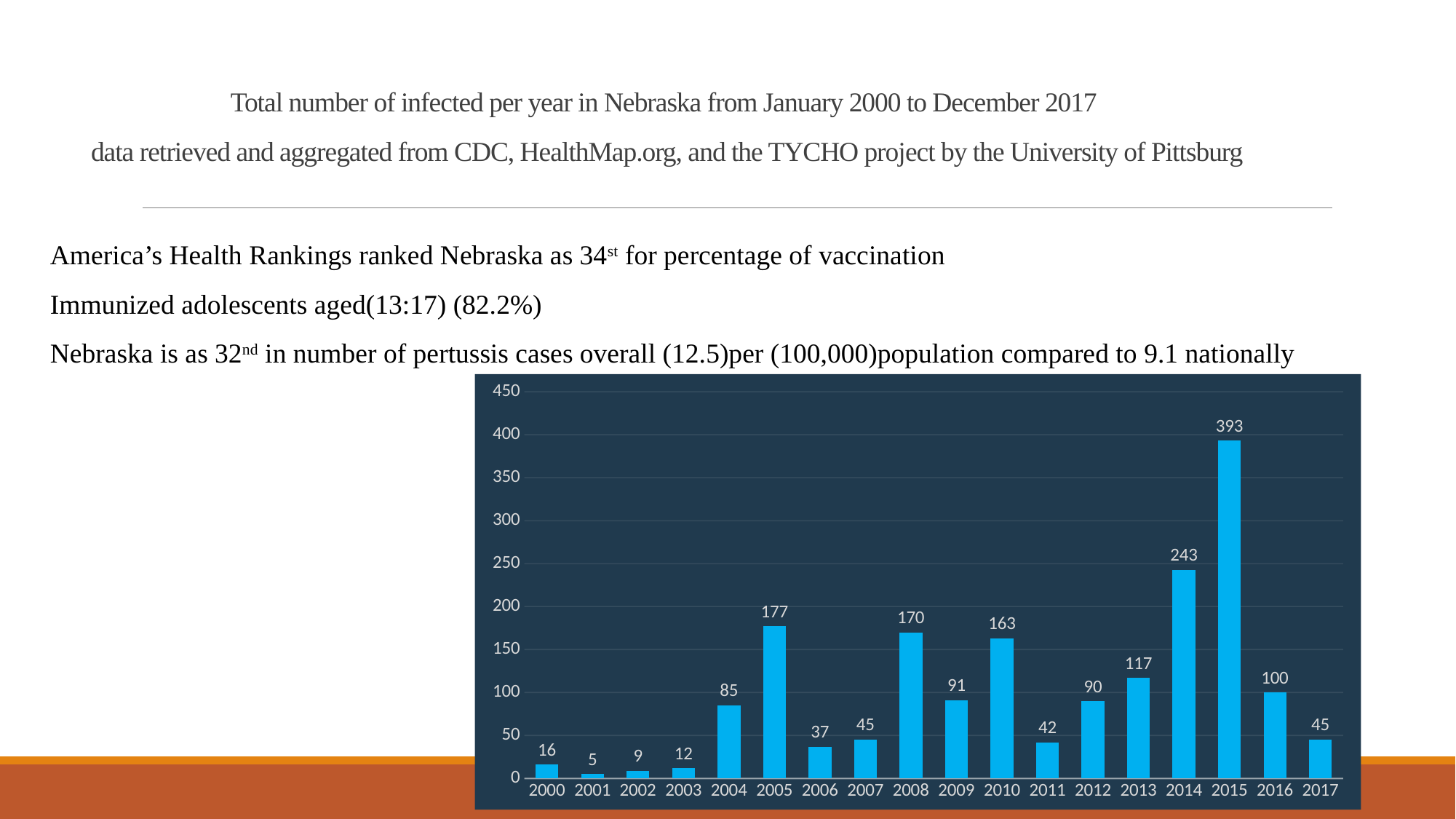
What is the number of infected in Nebraska in 2001? 5 Is the value for 2014 greater or less than 200? greater What is the number of infected in Nebraska in 2005? 177 What is the difference between the number of infected in 2015 and 2014? 150 Which year has the highest number of infected? 2015 How many years are shown on the x axis of the chart? 18 What kind of chart is shown on the slide? bar chart What is the difference between the number of infected in 2008 and 2010? 7 Which year had more infected, 2013 or 2016? 2013 Which year has the lowest number of infected? 2001 Do the values rise or fall from 2000 to 2005? rise What is the number of infected in Nebraska in 2015? 393